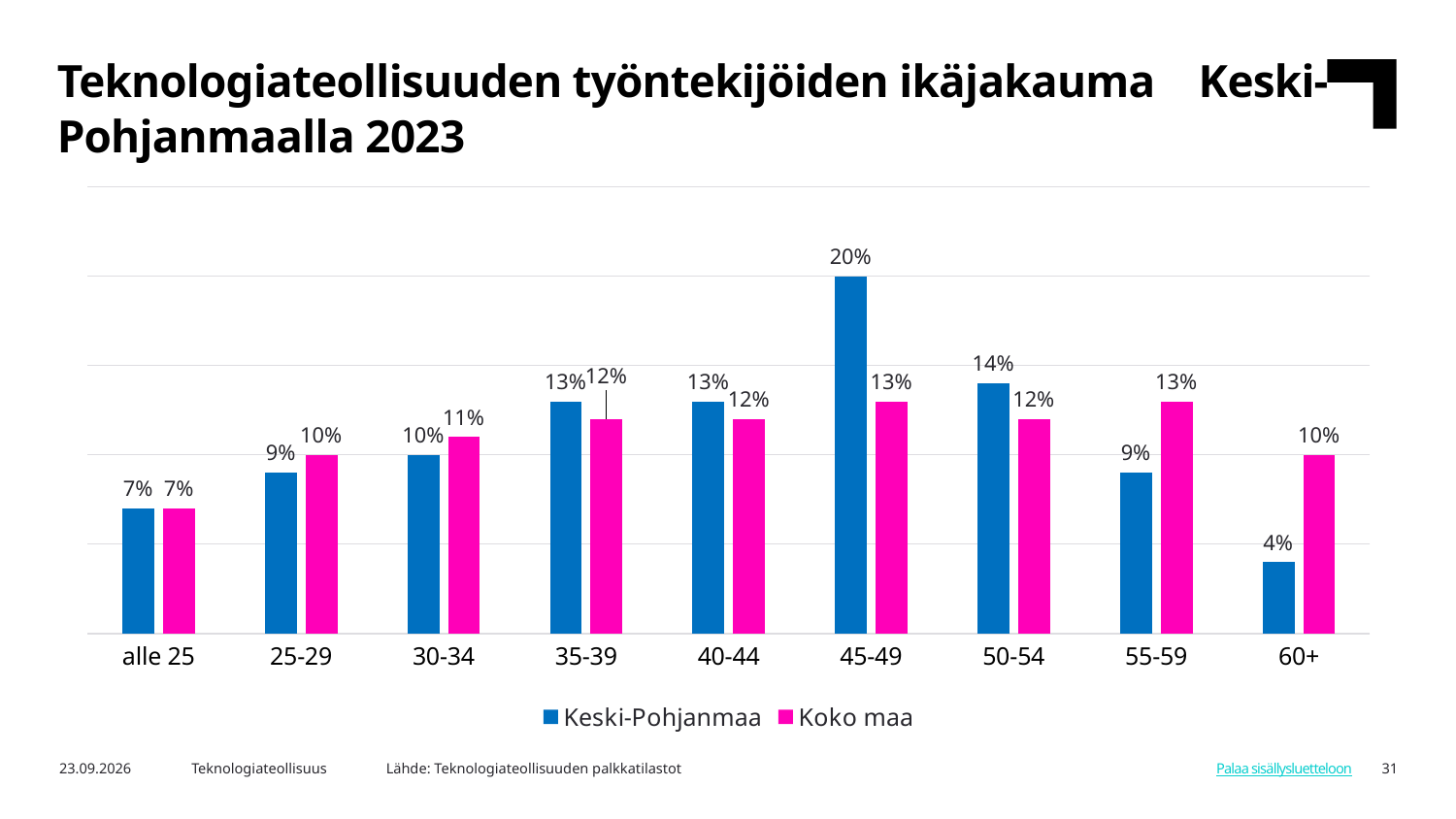
What is the difference between Koko maa and Keski-Pohjanmaa in the 60+ age group? 6 percentage points Which age group has the lowest value for Koko maa? alle 25 Which age group has the lowest value for Keski-Pohjanmaa? 60+ What is the value for Keski-Pohjanmaa in the 55-59 age group? 9% How many series does the legend list? 2 What is the difference between Keski-Pohjanmaa and Koko maa in the 45-49 age group? 7 percentage points What is the value for Keski-Pohjanmaa in the 45-49 age group? 20% How many age groups are shown on the x axis? 9 In the 55-59 age group, which series has the larger value, Keski-Pohjanmaa or Koko maa? Koko maa Which age group has the highest value for Keski-Pohjanmaa? 45-49 What kind of chart is shown on the slide? Bar chart What is the value for Koko maa in the 60+ age group? 10%